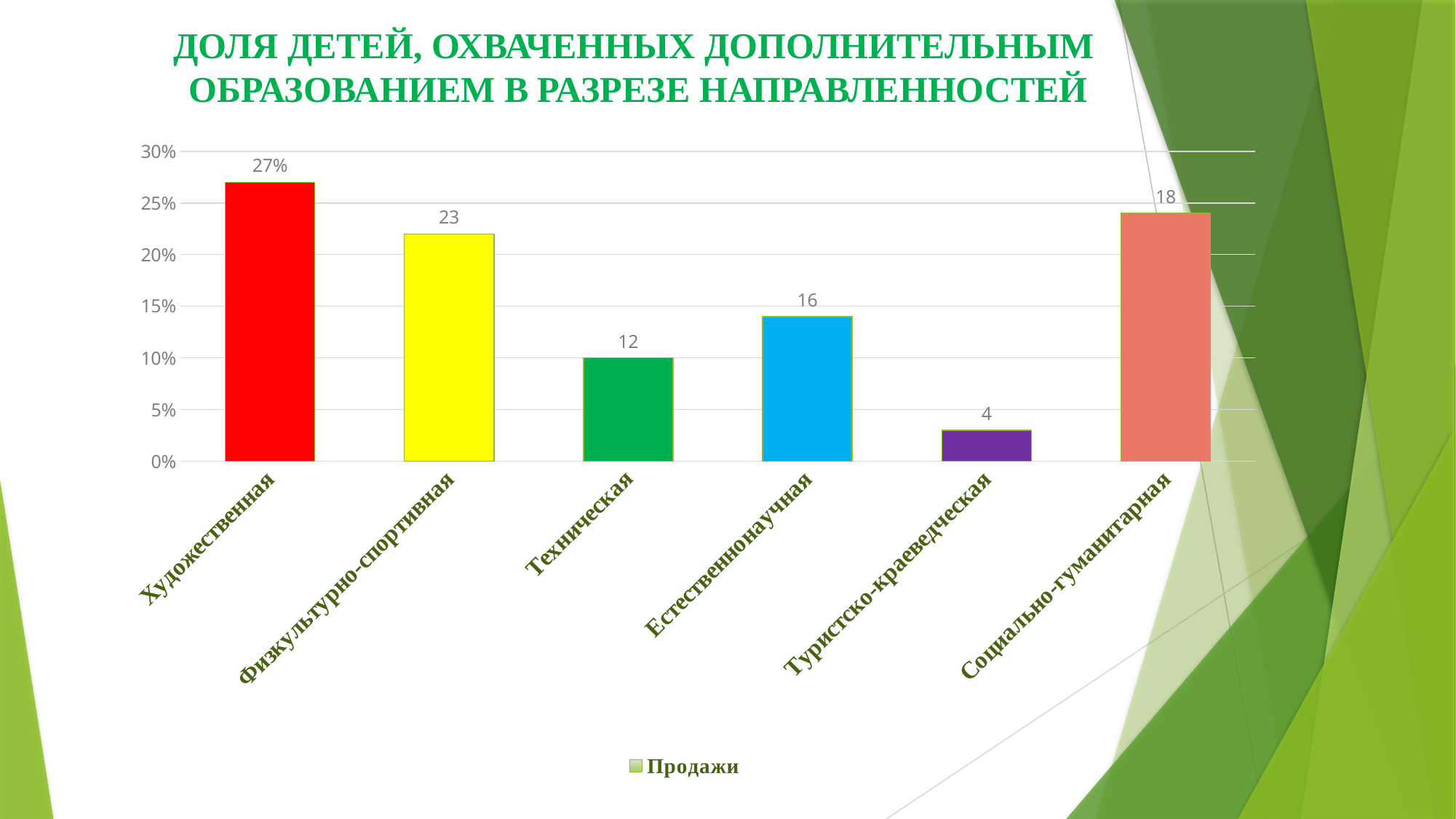
What kind of chart is shown on the slide? bar chart Which is larger, the value for Техническая or the value for Естественнонаучная? Естественнонаучная What is the value shown for Художественная? 27% What is the difference between the values for Естественнонаучная and Техническая? 4 What is the value shown for Естественнонаучная? 16 Which category has the lowest value? Туристско-краеведческая What is the value shown for Туристско-краеведческая? 4 What is the value shown for Техническая? 12 Which category has the highest value? Художественная How many categories are shown on the x axis? 6 How many series does the legend list? 1 Is the value for Туристско-краеведческая greater or less than 5%? less